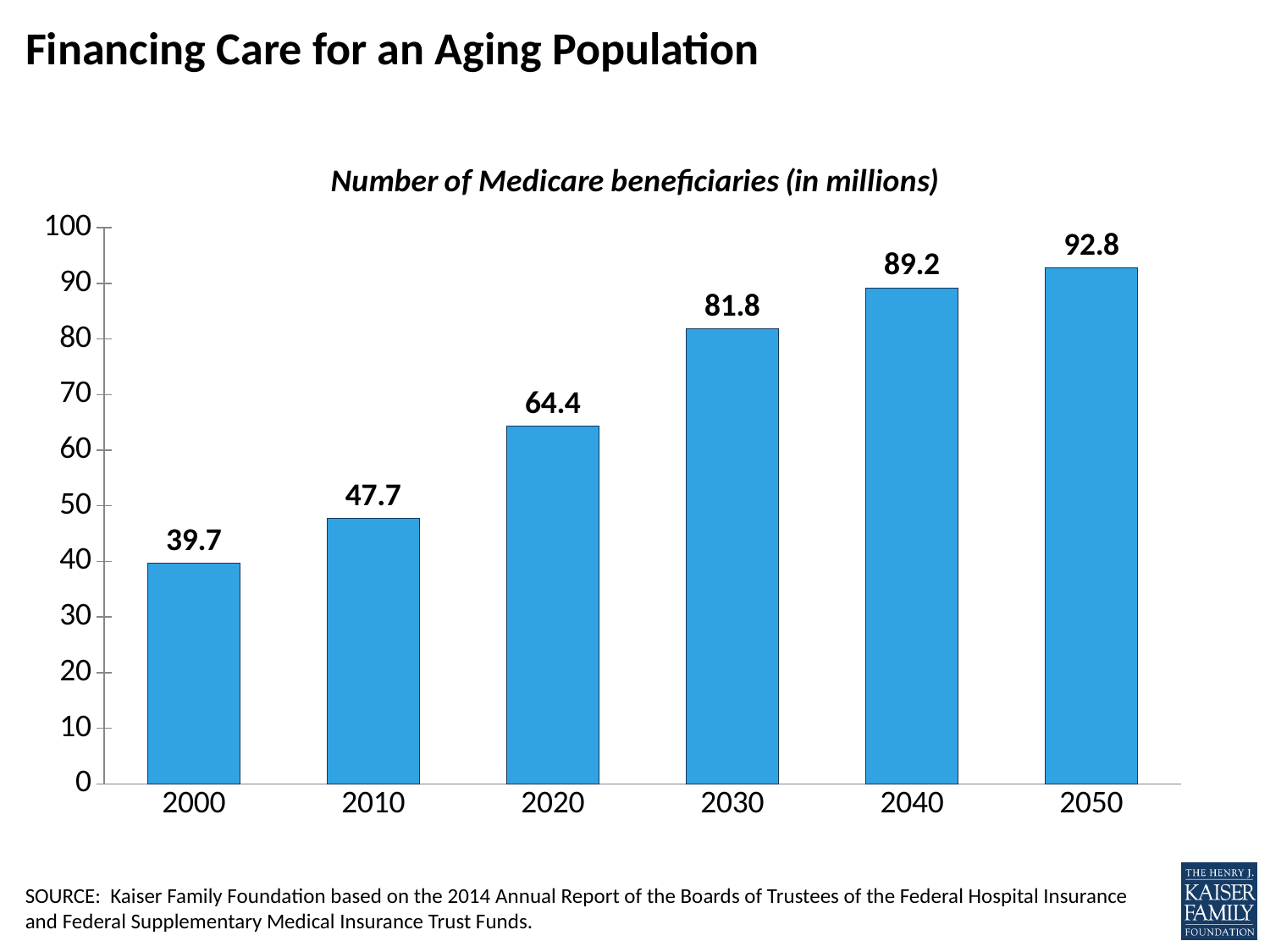
Which year has the highest number of Medicare beneficiaries? 2050 How many years are shown on the x axis? 6 What value is shown for 2040? 89.2 What is the number of Medicare beneficiaries (in millions) shown for 2020? 64.4 What kind of chart is shown on the slide? Bar chart Which year has the lowest number of Medicare beneficiaries? 2000 Do the values rise or fall from 2000 to 2050? Rise What value is shown for 2000? 39.7 Is the value for 2030 greater or less than 80? greater What is the difference between the values for 2050 and 2000? 53.1 What is the difference between the values for 2030 and 2020? 17.4 Which is larger, the value for 2010 or the value for 2030? 2030